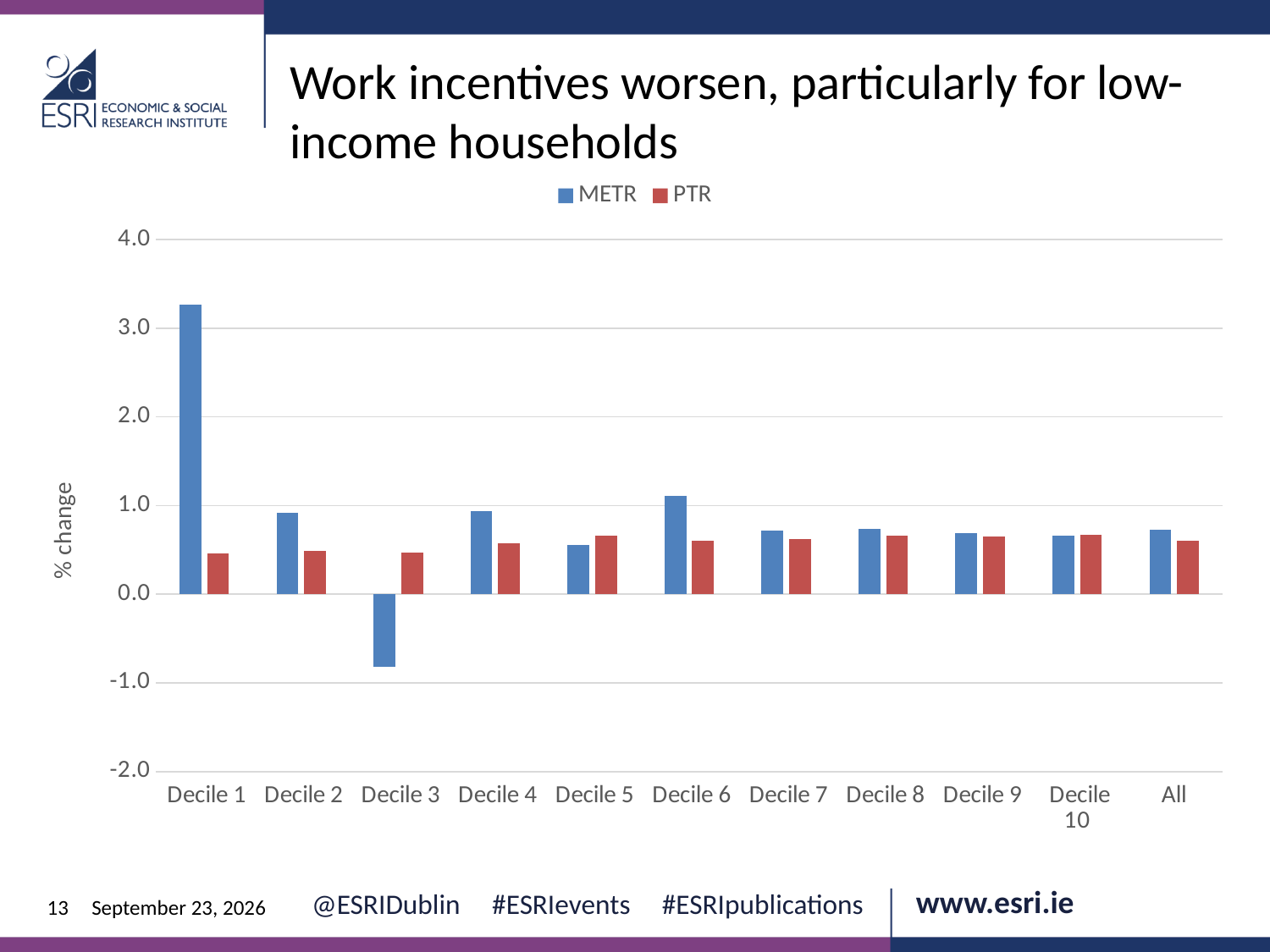
Is the METR value for Decile 1 greater or less than 3.0? greater Is the METR value for Decile 6 greater or less than 1.0? greater Which category has the highest METR value? Decile 1 For Decile 5, which series has the larger value, METR or PTR? PTR What are the two series named in the legend? METR and PTR Which category has the lowest METR value? Decile 3 For Decile 1, which series has the larger value, METR or PTR? METR How many series does the legend list? 2 What kind of chart is shown on the slide? Bar chart What is the label on the y axis? % change Is the METR value for Decile 3 greater or less than 0.0? less How many categories are shown on the x axis? 11